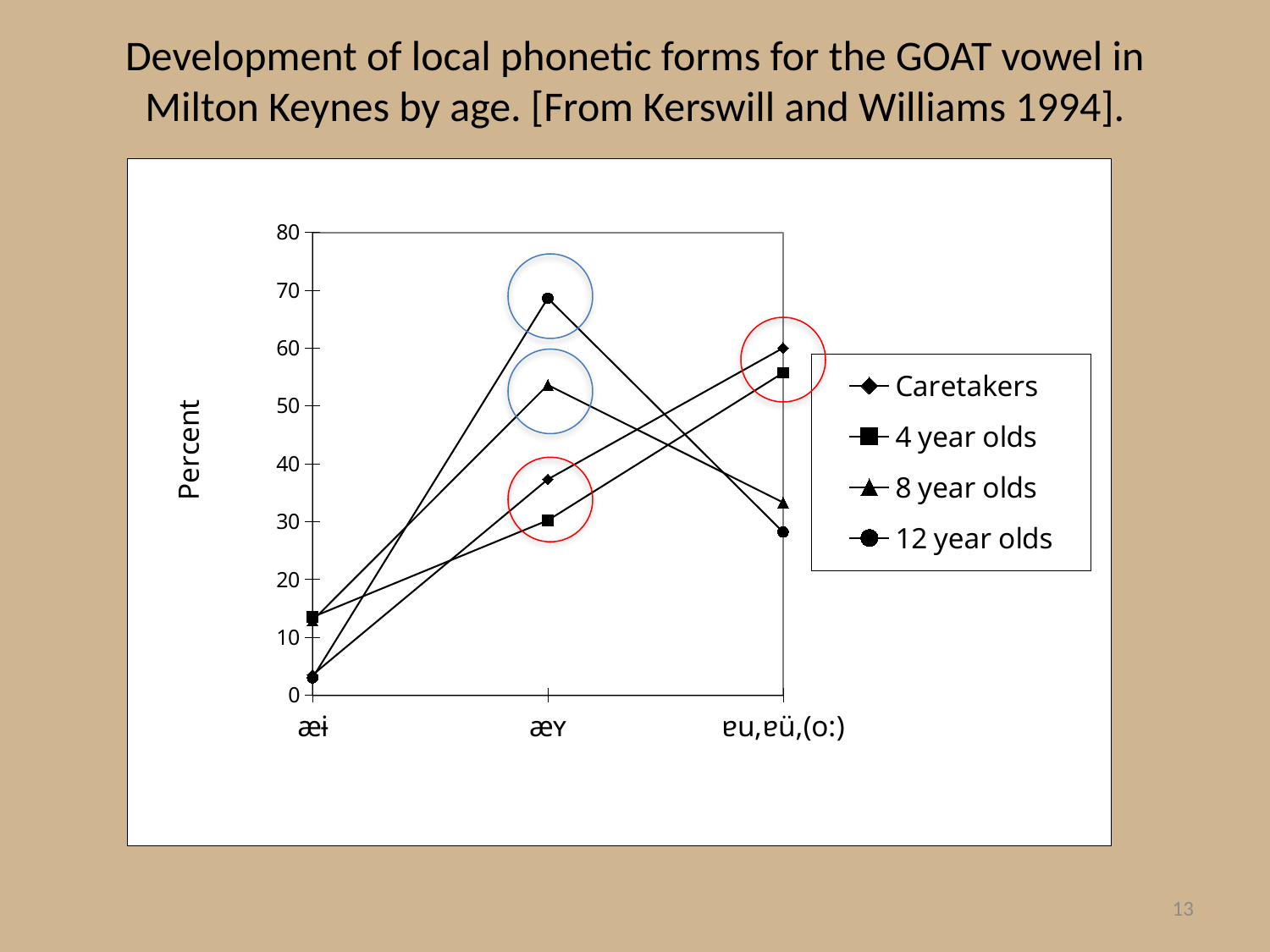
Is the value for 4 year olds at æʏ greater or less than 40? less Do the values for Caretakers rise or fall from æɨ to ɐu,ɐü,(oː)? rise How many categories are shown on the x axis? 3 Is the value for Caretakers at ɐu,ɐü,(oː) greater or less than 50? greater What is the label on the y axis? Percent Is the value for 12 year olds at æʏ greater or less than 60? greater How many series does the legend list? 4 What kind of chart is shown on the slide? line chart At ɐu,ɐü,(oː), which is larger: the value for Caretakers or the value for 8 year olds? Caretakers Which series has the highest value at æʏ? 12 year olds